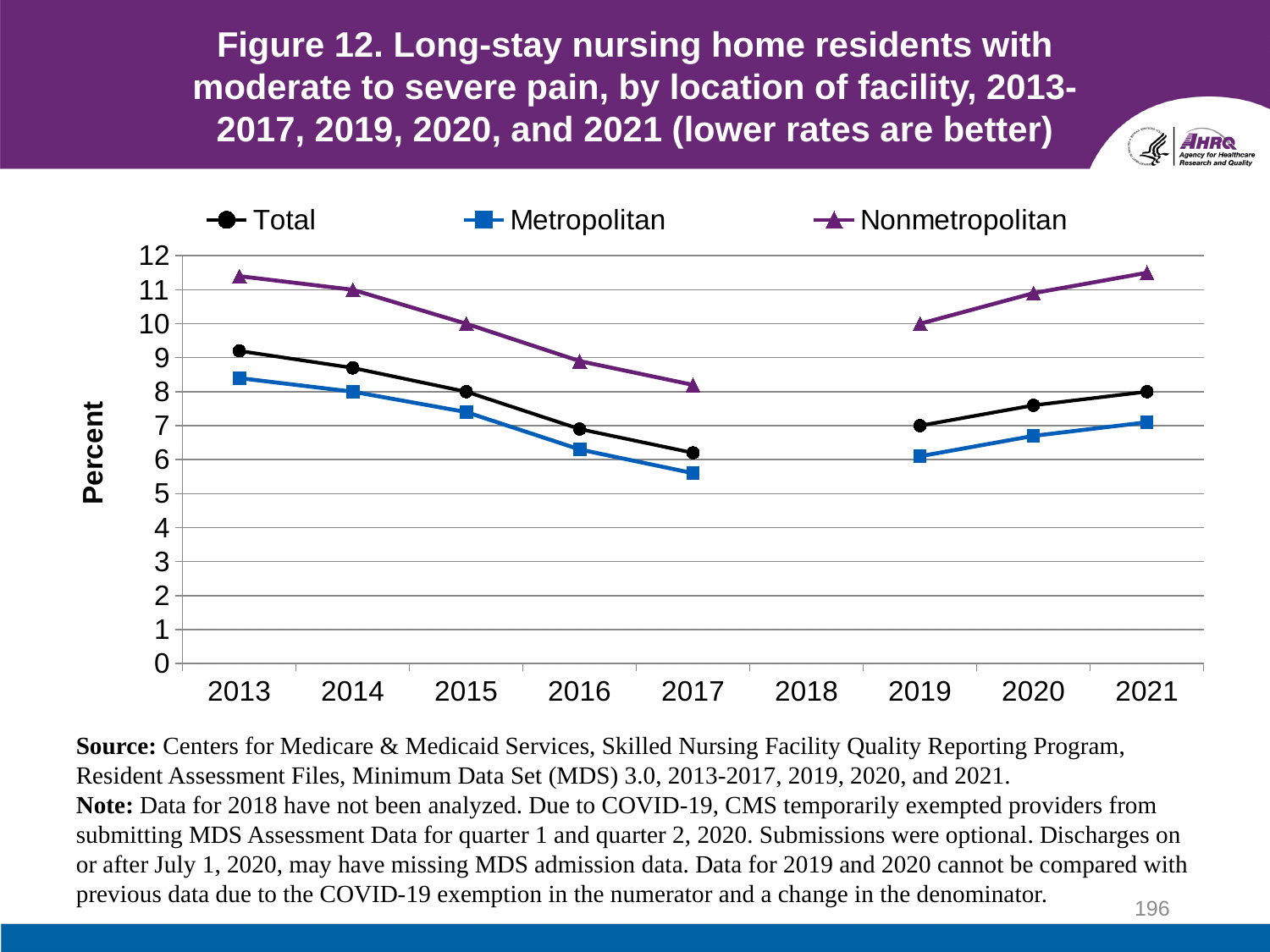
From 2013 to 2017, do the Total values rise or fall? fall Which series has the lowest value in 2017? Metropolitan Is the Nonmetropolitan value for 2017 greater or less than 9? less Which series has the highest value in 2013? Nonmetropolitan Is the Total value for 2013 greater or less than 9? greater From 2019 to 2021, do the Metropolitan values rise or fall? rise Is the Metropolitan value for 2017 greater or less than 6? less What kind of chart is shown on the slide? line chart Which is larger, the Nonmetropolitan value in 2021 or the Nonmetropolitan value in 2019? 2021 Which year on the x axis has no data points plotted? 2018 How many series does the legend list? 3